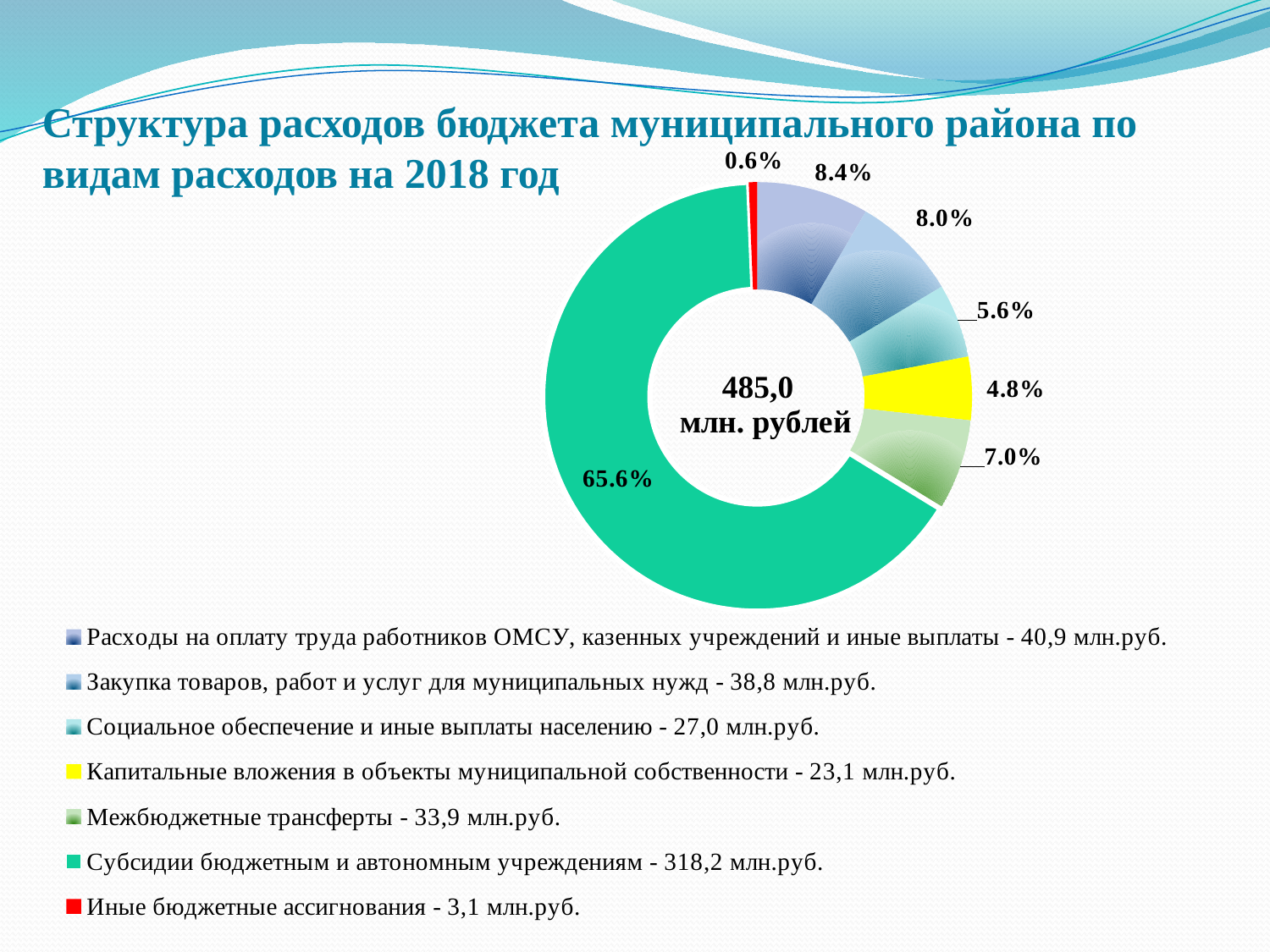
What kind of chart is shown on the slide? Doughnut (pie) chart What amount in млн.руб. does the legend give for Межбюджетные трансферты? 33,9 млн.руб. How many entries does the legend list? 7 How many slices does the chart have? 7 What total amount is printed in the centre of the chart? 485,0 млн. рублей Which is larger: the share for Межбюджетные трансферты or the share for Капитальные вложения в объекты муниципальной собственности? Межбюджетные трансферты What amount in млн.руб. does the legend give for Закупка товаров, работ и услуг для муниципальных нужд? 38,8 млн.руб. What is the difference in percentage points between the share for Расходы на оплату труда работников ОМСУ (8.4%) and the share for Социальное обеспечение и иные выплаты населению (5.6%)? 2.8 percentage points What share of the chart is labelled for the yellow slice, Капитальные вложения в объекты муниципальной собственности? 4.8% Which category has the largest share of the chart? Субсидии бюджетным и автономным учреждениям What share of the chart is labelled for Субсидии бюджетным и автономным учреждениям? 65.6% Which category has the smallest share of the chart? Иные бюджетные ассигнования